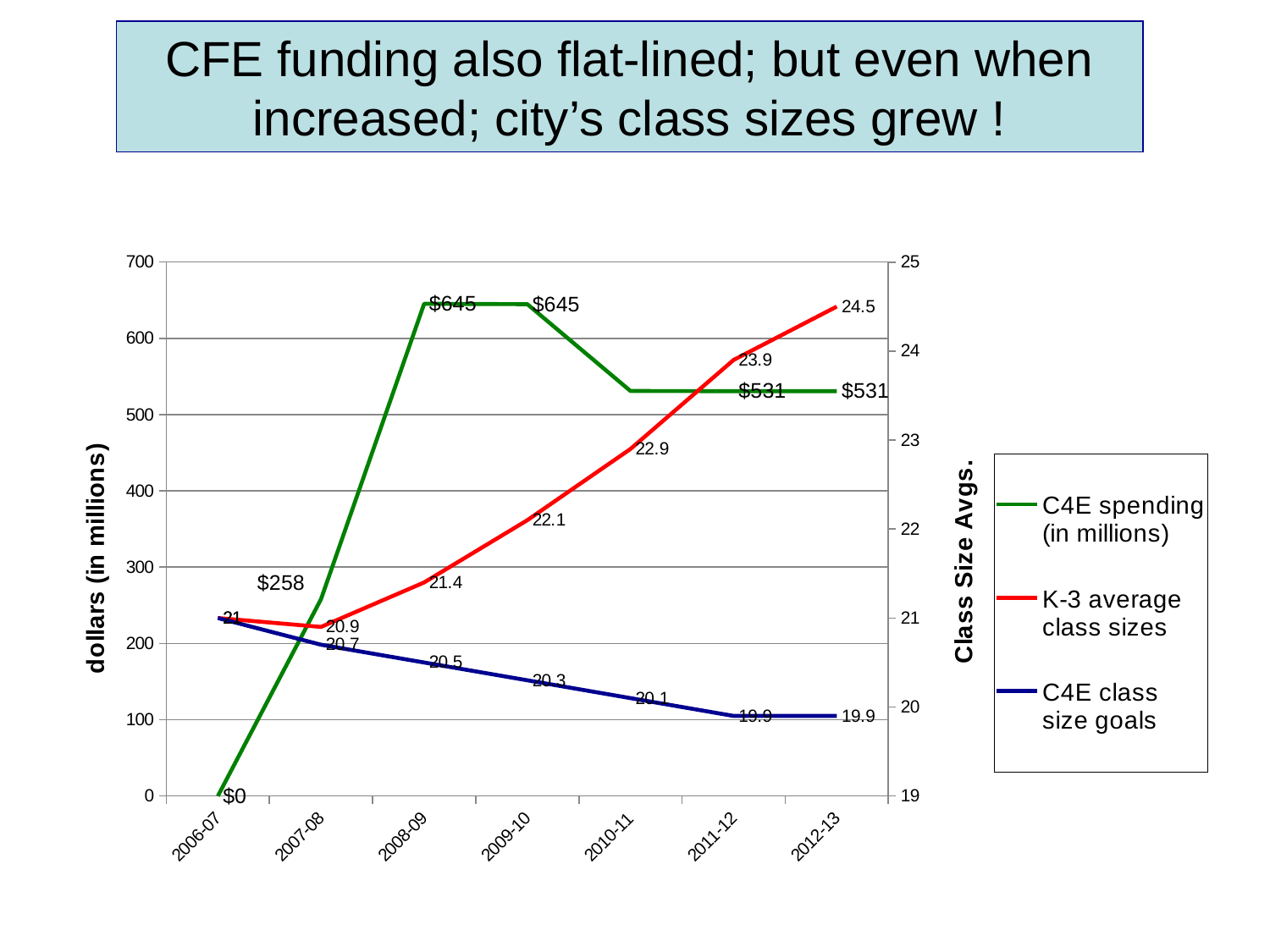
What was the K-3 average class size in 2012-13? 24.5 What kind of chart is shown on the slide? line chart In which school year was the K-3 average class size highest? 2012-13 Do the C4E class size goals rise or fall from 2007-08 to 2012-13? fall In 2010-11, which was larger: the K-3 average class size or the C4E class size goal? K-3 average class size What was the C4E class size goal for 2011-12? 19.9 How many series does the legend list? 3 How many school years are shown on the x axis? 7 What is the title of the right-hand vertical axis? Class Size Avgs. By how much did C4E spending (in millions) fall from 2009-10 to 2010-11? $114 What was C4E spending (in millions) in 2007-08? $258 What was C4E spending (in millions) in 2008-09? $645